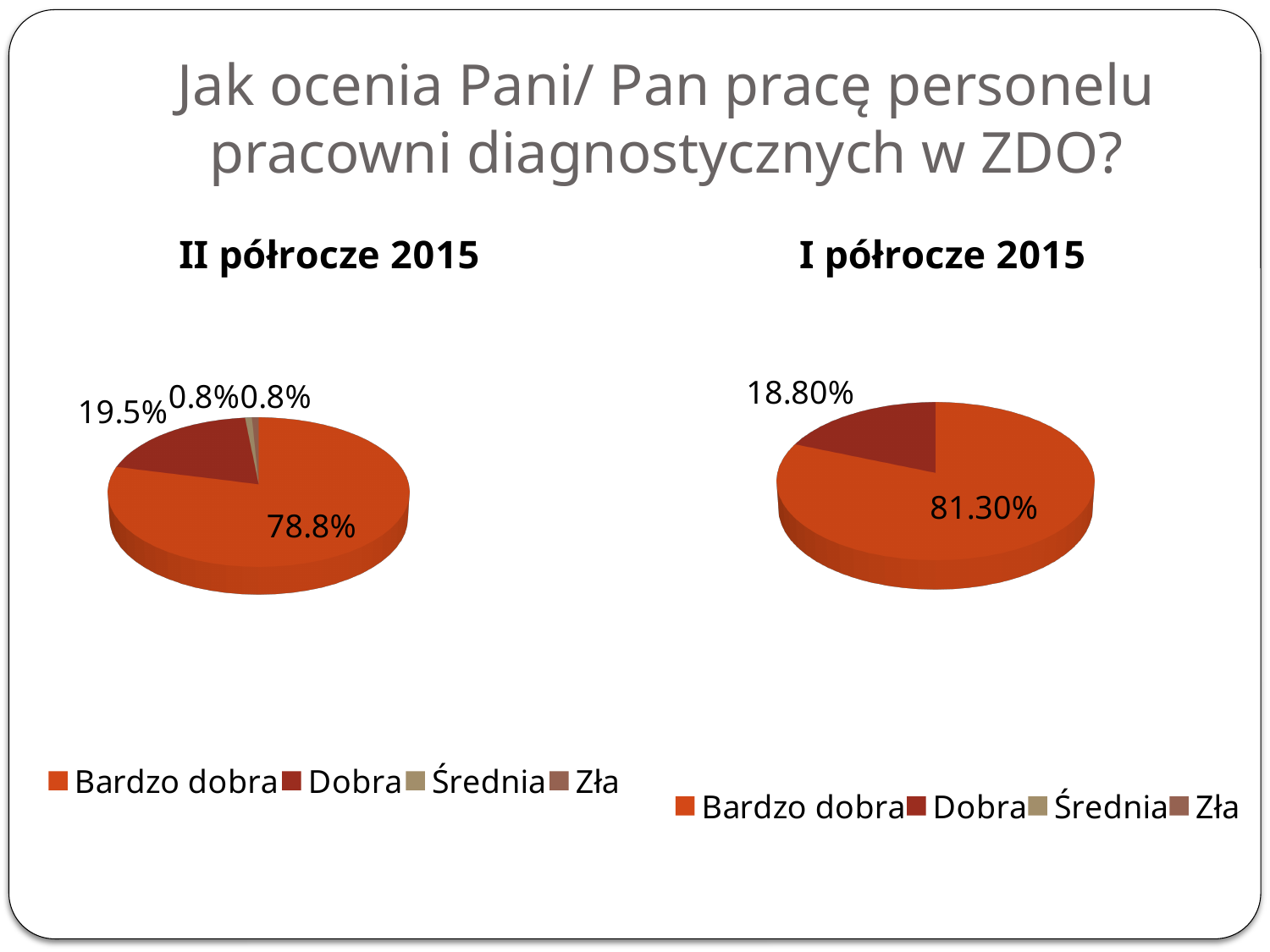
In the "I półrocze 2015" chart, what share is labelled for Bardzo dobra? 81.30% In the "II półrocze 2015" chart, what share is labelled for Dobra? 19.5% In the "II półrocze 2015" chart, what share is labelled for Bardzo dobra? 78.8% How many categories does the legend of the "I półrocze 2015" chart list? 4 In the "II półrocze 2015" chart, which category has the largest slice? Bardzo dobra In the "I półrocze 2015" chart, what is the difference between the Bardzo dobra and Dobra shares? 62.50% In the "II półrocze 2015" chart, what is the difference between the Bardzo dobra and Dobra shares? 59.3% Is the Bardzo dobra share larger in the "II półrocze 2015" chart or the "I półrocze 2015" chart? I półrocze 2015 In the "I półrocze 2015" chart, which category has the largest slice? Bardzo dobra What type of chart is used for "II półrocze 2015"? Pie chart In the "I półrocze 2015" chart, what share is labelled for Dobra? 18.80% In the "II półrocze 2015" chart, what share is labelled for Średnia? 0.8%